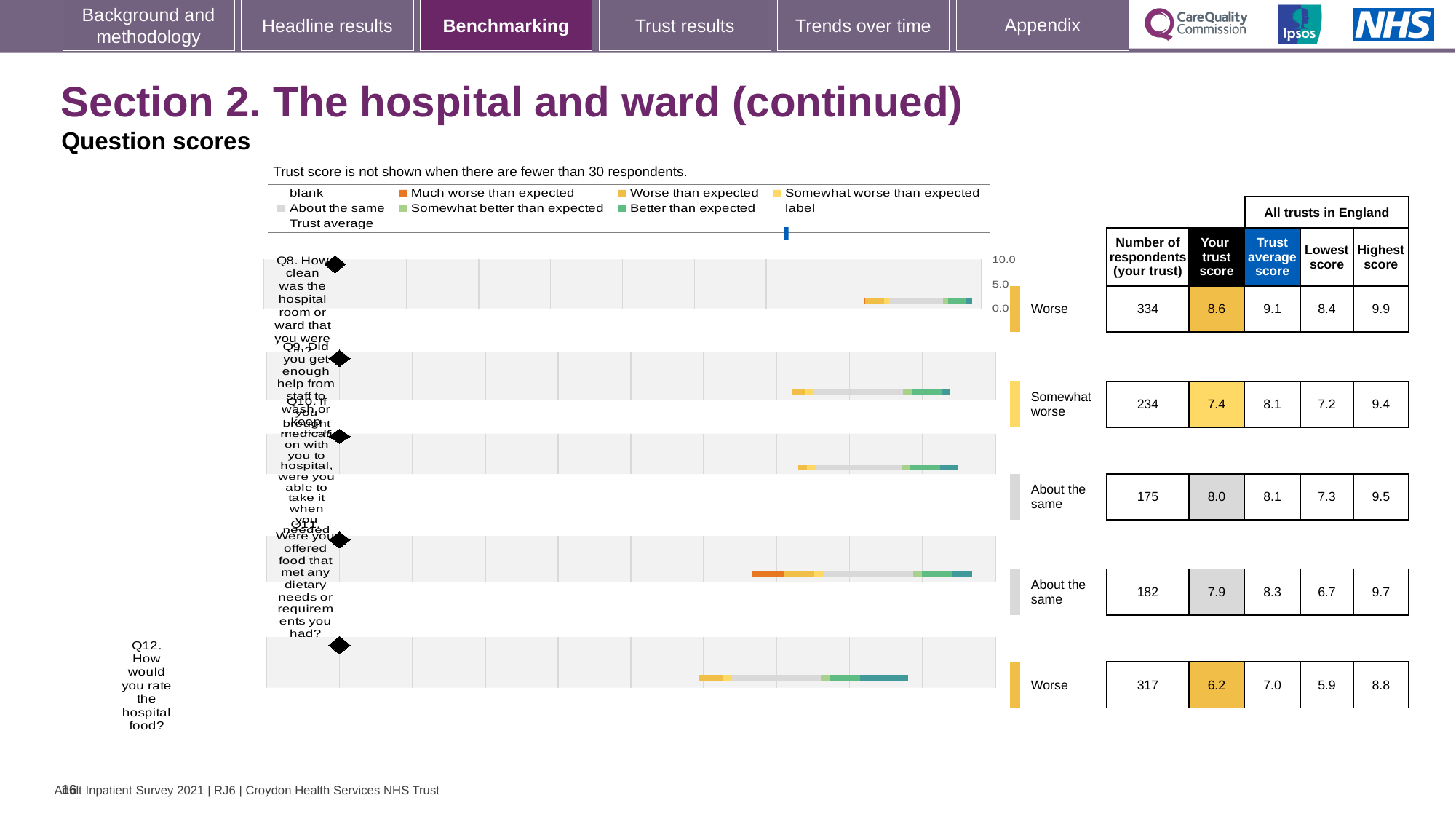
What is the trust average score for Q10? 8.1 Which question has the lowest trust score? Q12 Which has the larger trust score, Q9 or Q11? Q11 How many questions (Q8 to Q12) are plotted on the chart? 5 What is the lowest score across all trusts in England for Q11? 6.7 What is the difference between the trust average score and this trust's score for Q12? 0.8 What benchmark category is shown for Q12? Worse Which question has the highest trust score? Q8 What is the trust score for Q12 (How would you rate the hospital food?)? 6.2 What is the highest score across all trusts in England for Q9? 9.4 How many respondents answered Q8 (How clean was the hospital room or ward)? 334 What kind of chart is used to show the question scores on this slide? bar chart